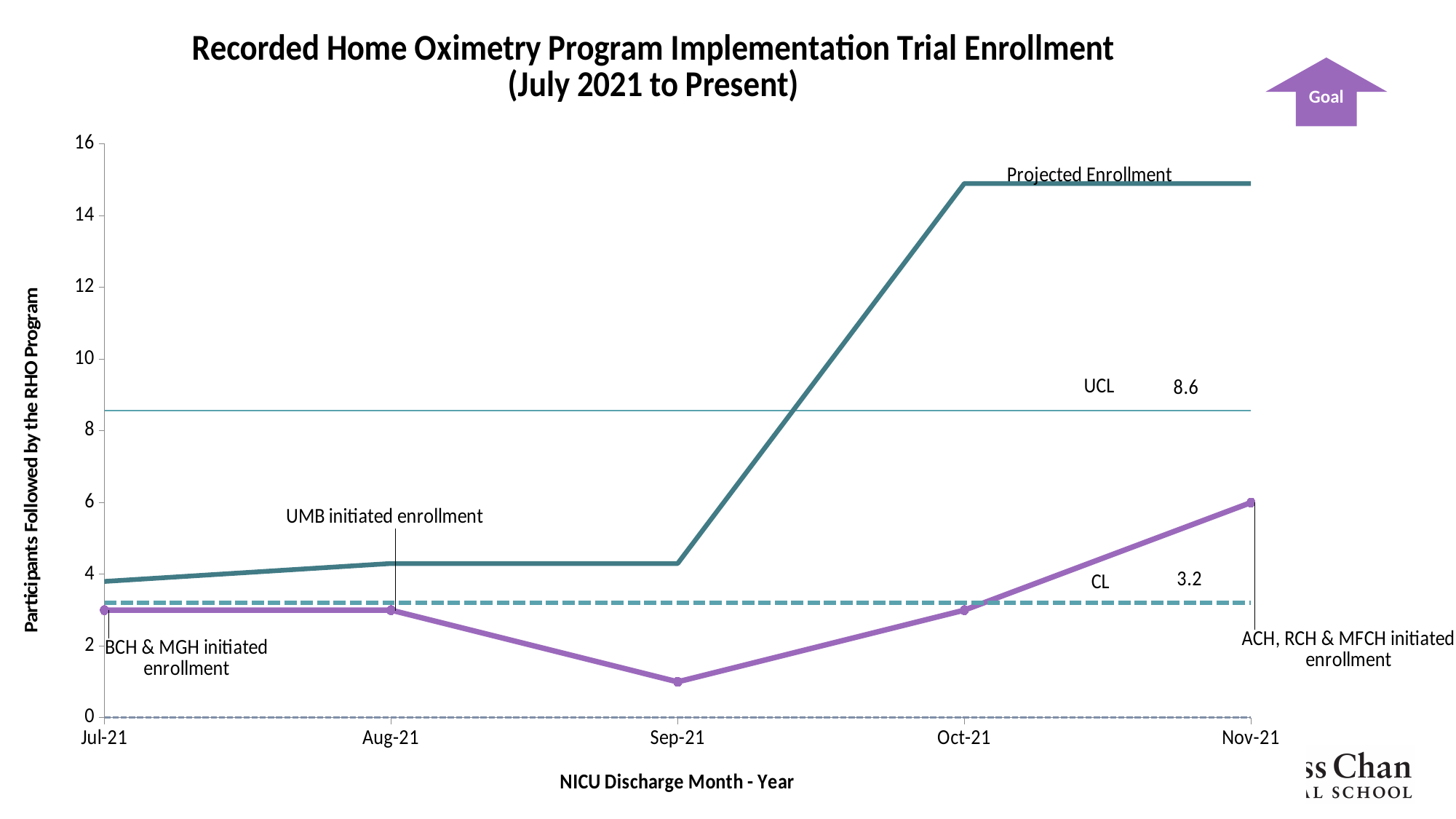
What is the value of the UCL line? 8.6 In which month is the purple actual enrollment line at its highest? Nov-21 In Nov-21, which is larger: the Projected Enrollment or the actual enrollment on the purple line? Projected Enrollment What kind of chart is shown on the slide? line chart Is the Projected Enrollment value for Nov-21 greater or less than 14? greater In which month is the purple actual enrollment line at its lowest? Sep-21 What is the label of the x axis? NICU Discharge Month - Year How many participants were followed by the RHO Program in Nov-21 (the purple line)? 6 Is the purple actual enrollment value for Sep-21 greater or less than 2? less What is the value of the CL line? 3.2 Does the purple actual enrollment line rise or fall from Sep-21 to Nov-21? rise How many months are shown on the x axis? 5